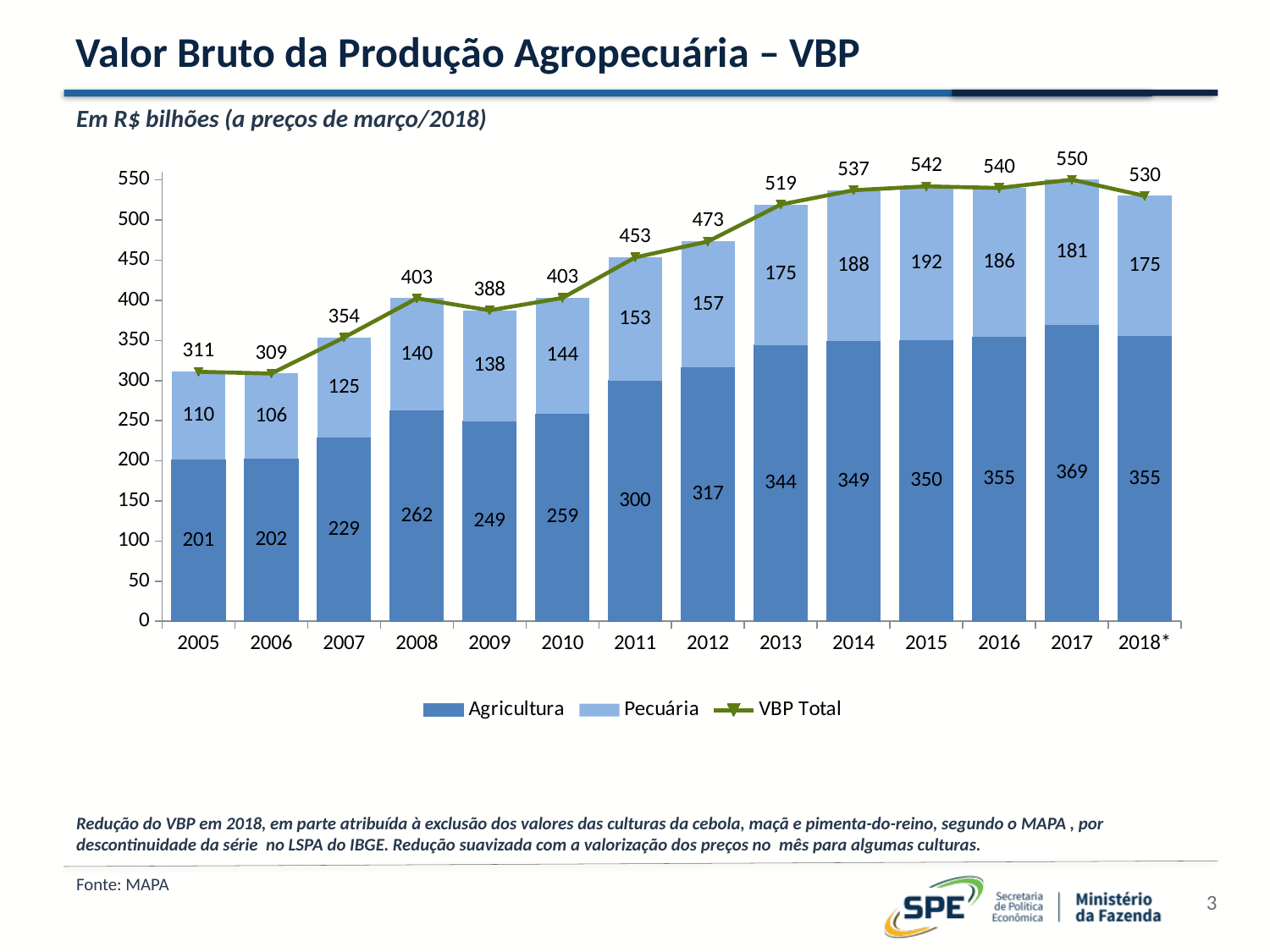
What kind of chart is shown on the slide? Stacked bar chart with a line How many years are shown on the x axis? 14 How many series does the legend list? 3 What is the total of the stacked bar for 2013? 519 What is the Agricultura value for 2011? 300 What is the difference between the Agricultura values for 2017 and 2016? 14 What is the VBP Total value for 2018*? 530 In which year is the Pecuária value lowest? 2006 What is the Pecuária value for 2014? 188 Does the VBP Total rise or fall from 2005 to 2017? Rises Which year has the larger Pecuária value, 2015 or 2016? 2015 In which year is the VBP Total highest? 2017